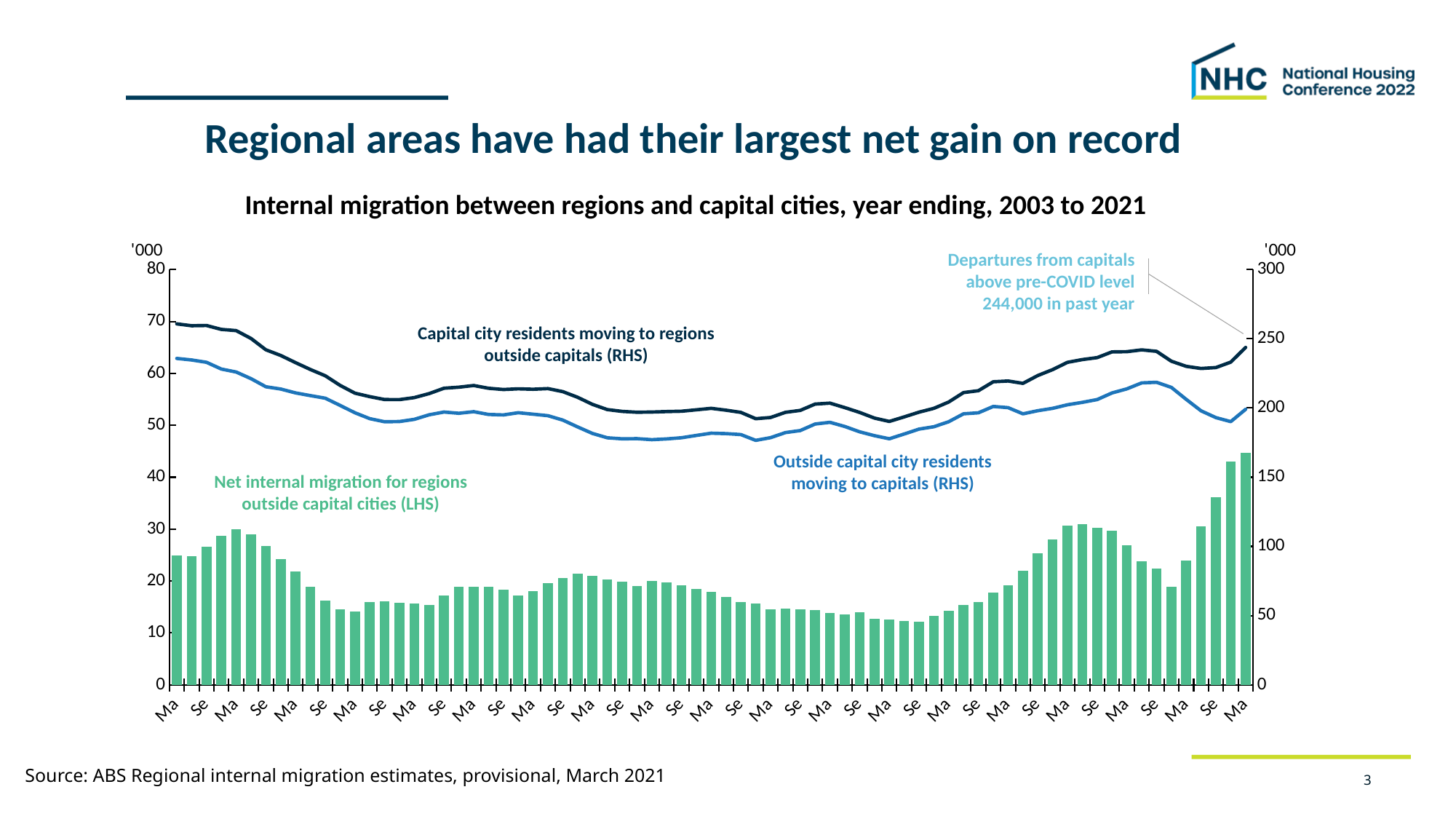
Which line is higher throughout the chart: 'Capital city residents moving to regions outside capitals' or 'Outside capital city residents moving to capitals'? Capital city residents moving to regions outside capitals According to the annotation, how many departures from capitals were there in the past year? 244,000 Is the value of the last bar (Mar 2021) greater or less than 40 on the left-hand axis? greater Do the net internal migration bars rise or fall over the final few periods of the chart? rise Which bar is the highest in the chart? The last bar (Mar 2021) Is the final value of the 'Capital city residents moving to regions outside capitals' line greater or less than 200 on the right-hand axis? greater How many data series are labelled on the chart? 3 What kind of chart is shown on the slide? A combined bar and line chart Which series is plotted as bars on the chart? Net internal migration for regions outside capital cities (LHS) Is the lowest point of the 'Outside capital city residents moving to capitals' line greater or less than 200 on the right-hand axis? less What is the title of the chart? Internal migration between regions and capital cities, year ending, 2003 to 2021